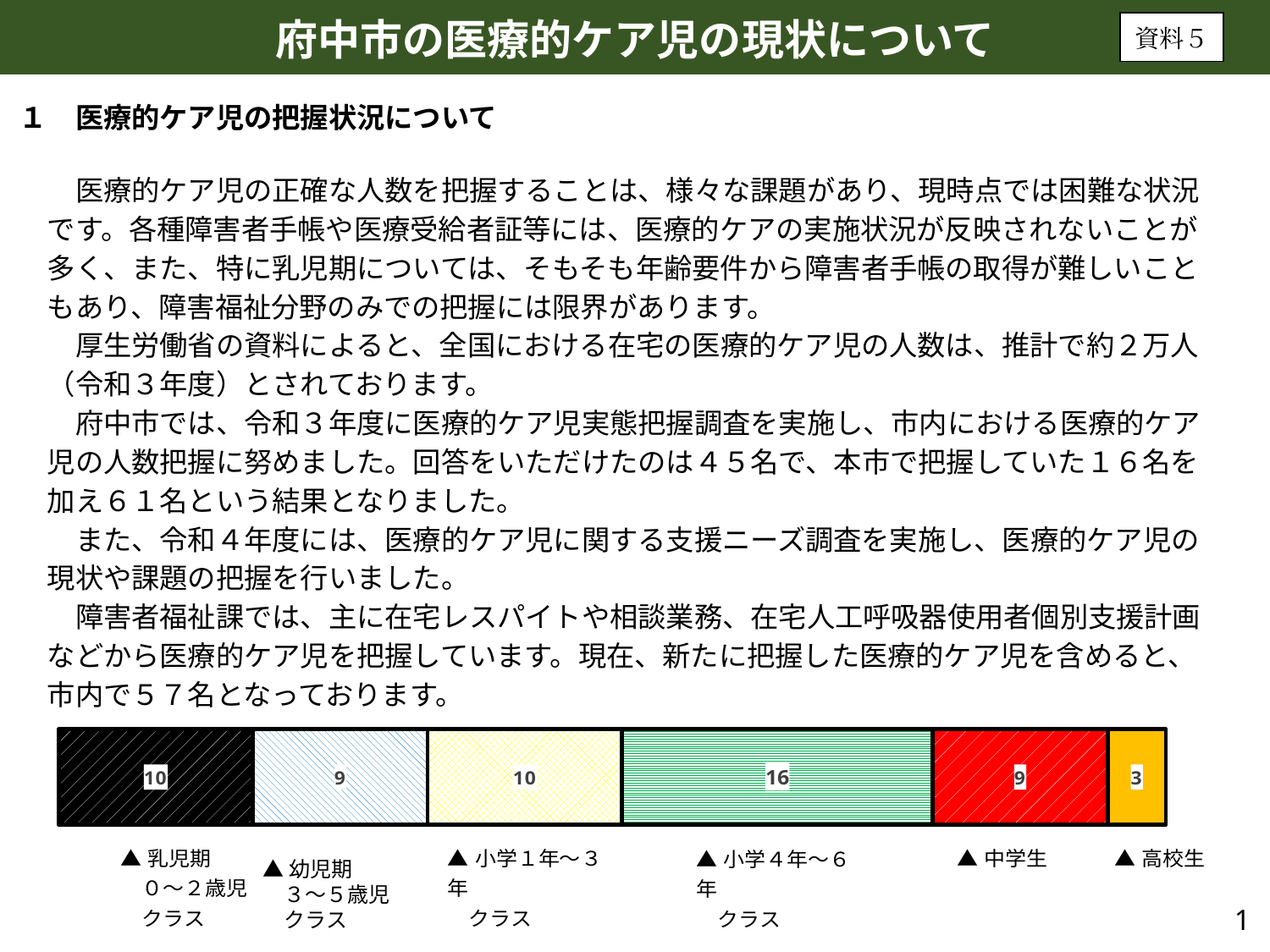
What is the value for the 乳児期 ０～２歳児クラス segment of the bar chart? 10 Which segment of the bar chart has the lowest value? 高校生 What is the value for the 高校生 segment of the bar chart? 3 What is the difference between the 小学４年～６年クラス value and the 高校生 value in the bar chart? 13 What is the value for the 小学４年～６年クラス segment of the bar chart? 16 What is the total of all segments in the stacked bar chart? 57 Which is larger in the bar chart, the value for 幼児期 ３～５歳児クラス or the value for 小学１年～３年クラス? 小学１年～３年クラス What is the value for the 中学生 segment of the bar chart? 9 How many segments does the stacked bar chart have? 6 What kind of chart is shown at the bottom of the slide? Stacked bar chart What colour is the 中学生 segment of the bar chart? Red Which segment of the bar chart has the highest value? 小学４年～６年クラス